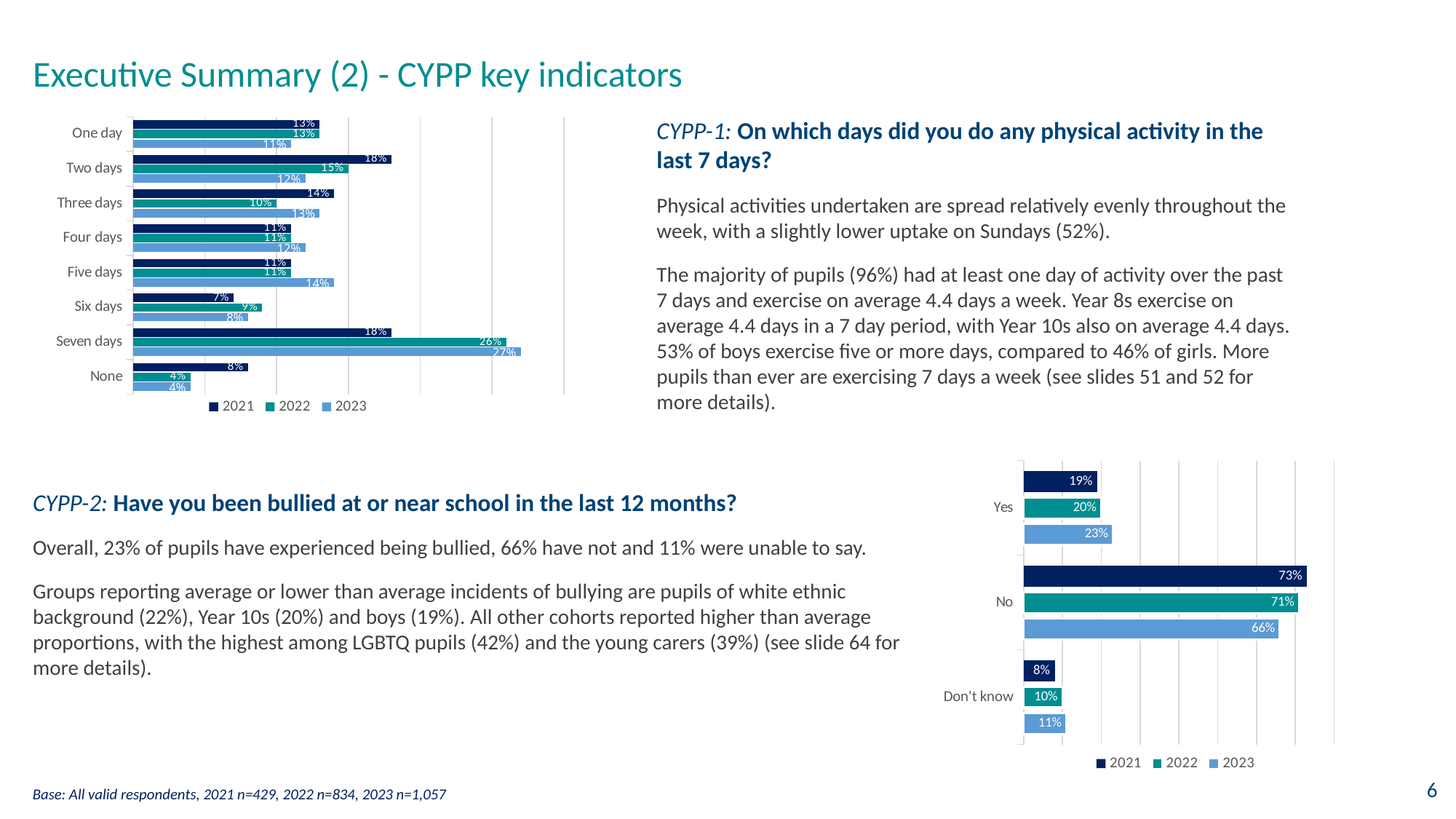
In the bottom-right chart, what is the 2021 value for "Yes"? 19% In the top-left chart, what is the 2021 value for "None"? 8% How many series does the legend of the bottom-right chart list? 3 What type of chart is the bottom-right chart? Bar chart In the top-left chart, what is the 2023 value for "Seven days"? 27% In the bottom-right chart, what is the 2022 value for "Don't know"? 10% In the bottom-right chart, which category has the lowest 2021 value? Don't know In the top-left chart, which is larger for "Two days": the 2021 value or the 2023 value? 2021 In the bottom-right chart, what is the difference between the 2021 and 2023 values for "No"? 7% How many categories are shown in the top-left chart? 8 In the bottom-right chart, what is the 2023 value for "No"? 66% In the top-left chart, which category has the highest 2022 value? Seven days